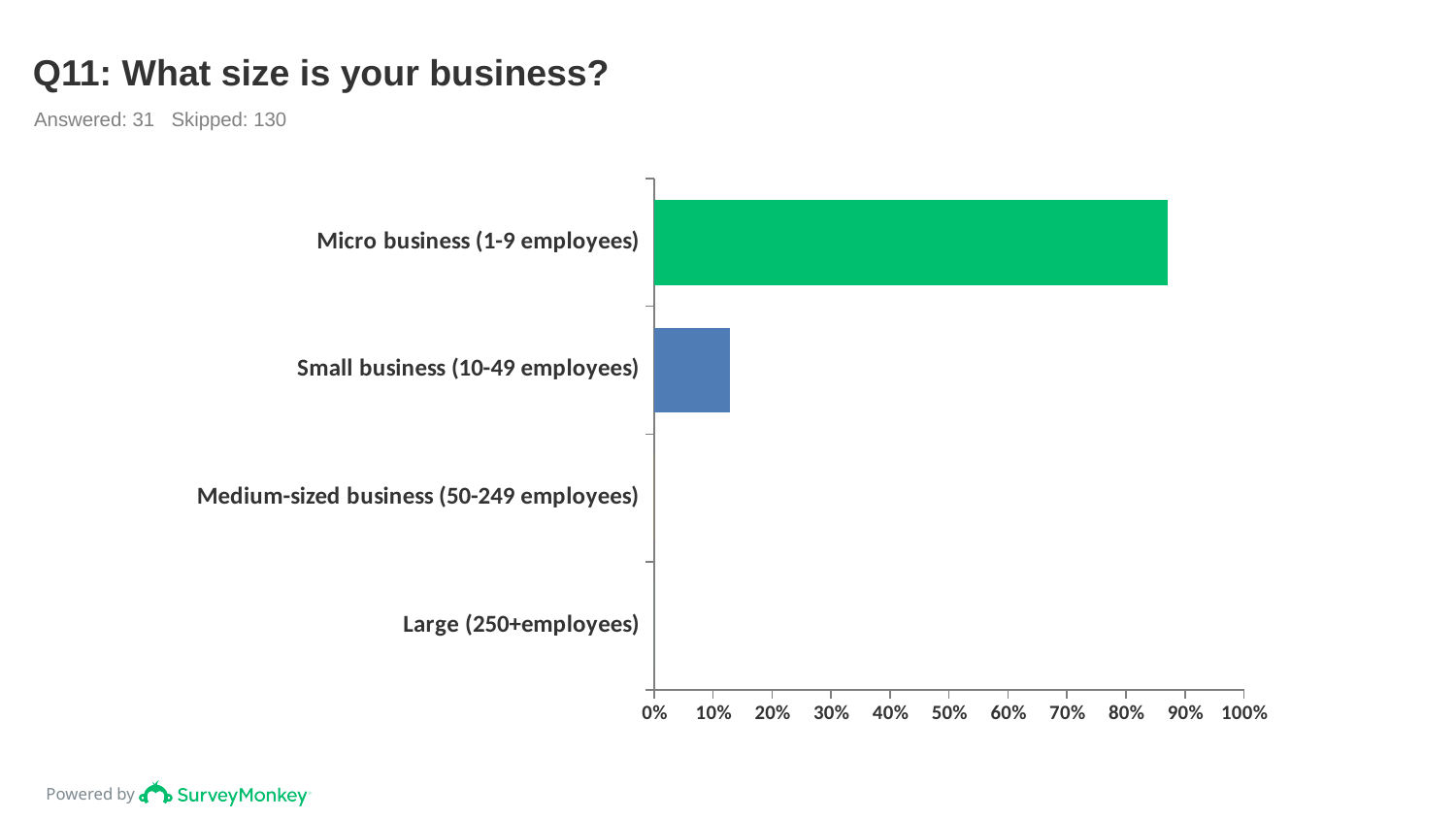
Which business size category has the highest value? Micro business (1-9 employees) How many respondents answered the question shown on the slide? 31 Which is larger, the value for Micro business (1-9 employees) or Small business (10-49 employees)? Micro business (1-9 employees) Which is larger, the value for Small business (10-49 employees) or Large (250+employees)? Small business (10-49 employees) Is the value for Small business (10-49 employees) greater or less than 10%? greater How many business size categories are shown on the chart? 4 Is the value for Micro business (1-9 employees) greater or less than 80%? greater Is the value for Small business (10-49 employees) greater or less than 20%? less What kind of chart is shown on the slide? bar chart What is the title of the chart? Q11: What size is your business?